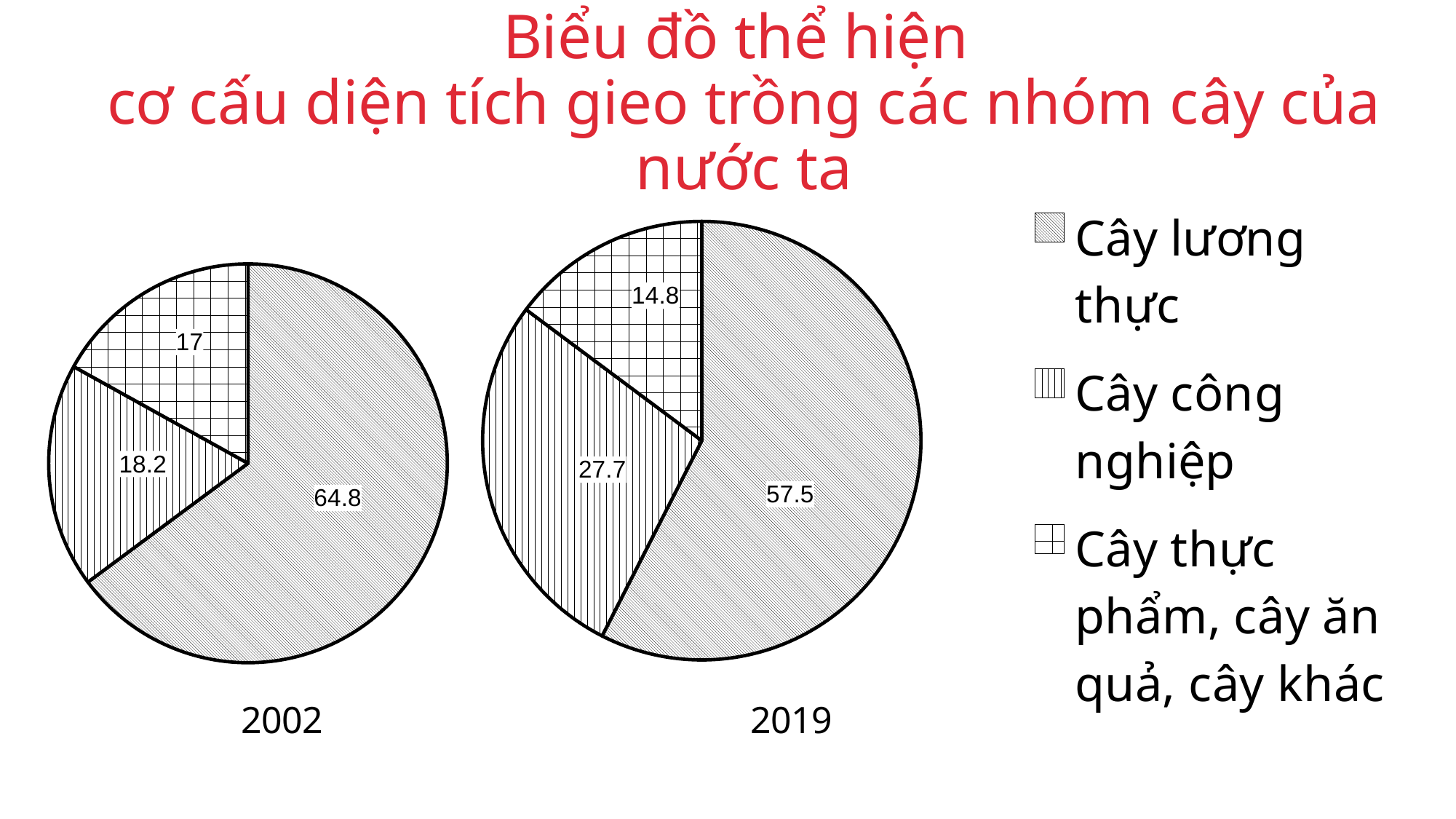
How many entries does the legend list? 3 How many slices does the 2002 pie chart have? 3 In the 2002 pie chart, what is the value for Cây thực phẩm, cây ăn quả, cây khác? 17 In the 2002 pie chart, which group has the smallest slice? Cây thực phẩm, cây ăn quả, cây khác In the 2019 pie chart, which group has the largest slice? Cây lương thực Is the Cây công nghiệp value larger in the 2002 pie chart or the 2019 pie chart? 2019 In the 2019 pie chart, what is the value for Cây công nghiệp? 27.7 In the 2019 pie chart, what is the value for Cây thực phẩm, cây ăn quả, cây khác? 14.8 In the 2002 pie chart, what is the value for Cây lương thực? 64.8 What is the difference between the Cây lương thực value in the 2002 pie chart and in the 2019 pie chart? 7.3 In the 2019 pie chart, what is the difference between Cây công nghiệp and Cây thực phẩm, cây ăn quả, cây khác? 12.9 What type of charts are shown on the slide? Pie charts